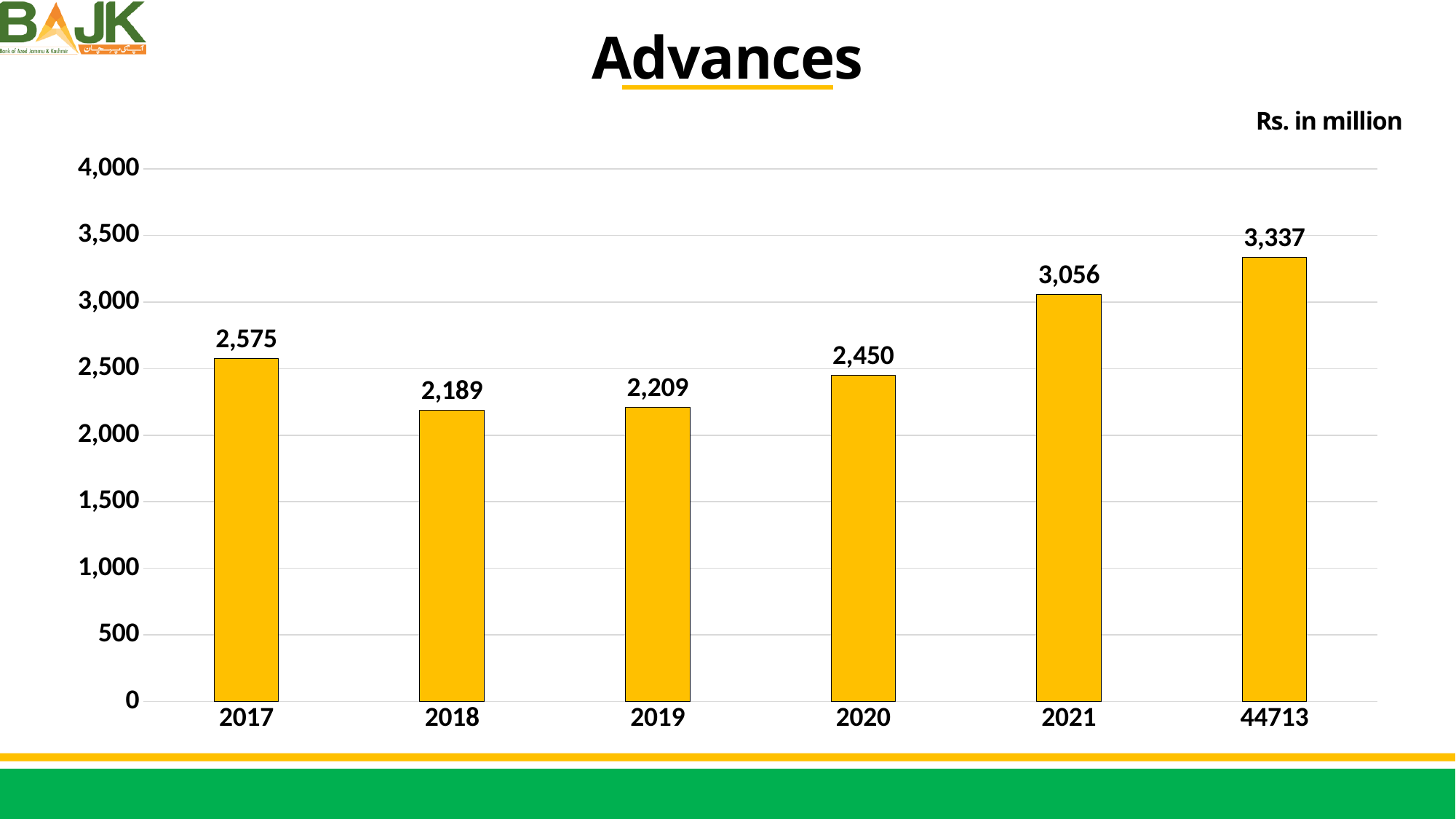
What is the value for 2017? 2,575 Which is larger, the value for 2017 or the value for 2020? 2017 How many categories are shown on the x axis? 6 What is the difference between the values for 2017 and 2018? 386 What is the value for 2020? 2,450 Which category has the highest value? 44713 What unit is stated for the values on the chart? Rs. in million Which category has the lowest value? 2018 Is the value for 2019 greater or less than 2,500? less What kind of chart is shown on the slide? bar chart What is the value for 2021? 3,056 What is the difference between the values for 2021 and 2020? 606